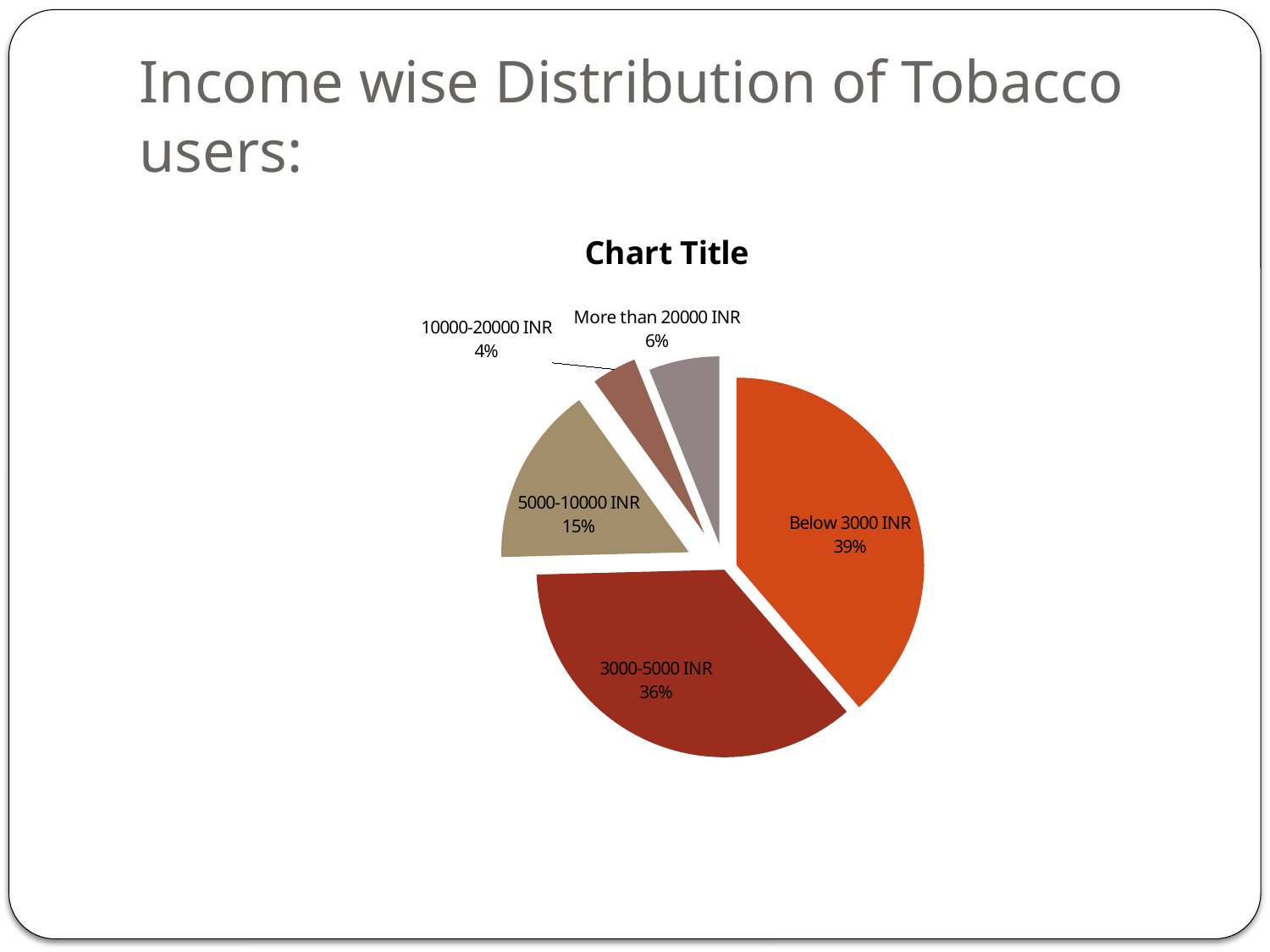
What share of the pie is the 5000-10000 INR slice? 15% What percentage is shown for the 10000-20000 INR income group? 4% What share of tobacco users earn more than 20000 INR? 6% Which income group has the largest share of tobacco users? Below 3000 INR What is the difference in percentage points between the Below 3000 INR and 3000-5000 INR slices? 3 What is the title printed above the chart? Chart Title How many income groups are shown in the pie chart? 5 Which income group has the smallest share of tobacco users? 10000-20000 INR What percentage of tobacco users fall in the 3000-5000 INR income group? 36% Which is larger, the share for 5000-10000 INR or the share for More than 20000 INR? 5000-10000 INR What type of chart is shown on the slide? Pie chart What share of tobacco users have an income below 3000 INR? 39%